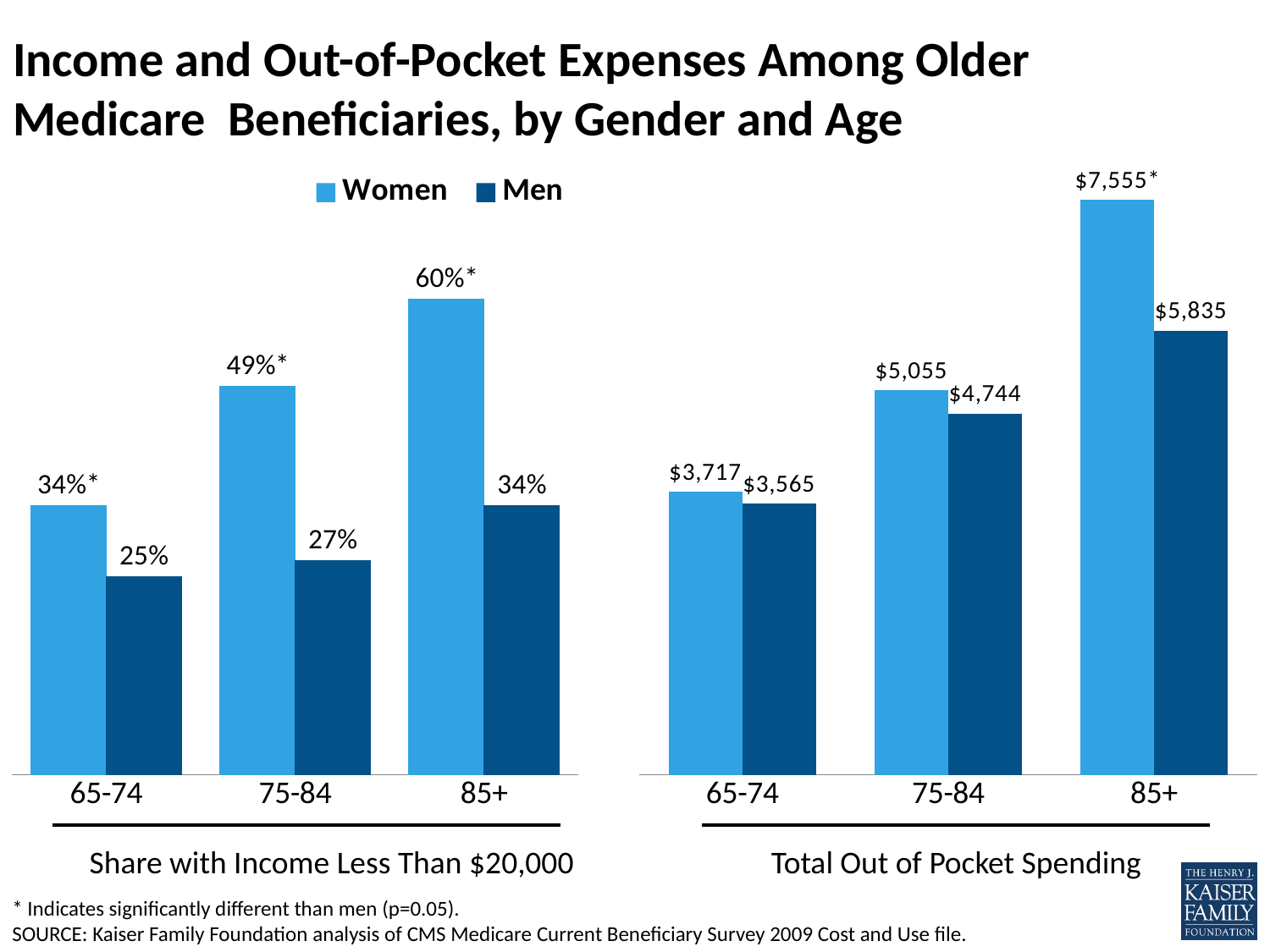
In the 'Total Out of Pocket Spending' chart, what is the value for Women aged 85+? $7,555 How many series does the legend list? 2 In the 'Total Out of Pocket Spending' chart, what is the difference between Women and Men aged 75-84? $311 In the 'Share with Income Less Than $20,000' chart, what is the value for Men aged 75-84? 27% In the 'Share with Income Less Than $20,000' chart, what is the difference between Women and Men aged 85+? 26 percentage points In the 'Share with Income Less Than $20,000' chart, what is the value for Women aged 65-74? 34% In the 'Total Out of Pocket Spending' chart, which is larger for the 85+ group, Women or Men? Women How many age groups are shown in the 'Share with Income Less Than $20,000' chart? 3 In the 'Share with Income Less Than $20,000' chart, which age group has the highest value for Women? 85+ In the 'Total Out of Pocket Spending' chart, which age group has the lowest value for Men? 65-74 In the 'Total Out of Pocket Spending' chart, what is the value for Men aged 65-74? $3,565 In the 'Total Out of Pocket Spending' chart, do the values for Women rise or fall as age increases? rise